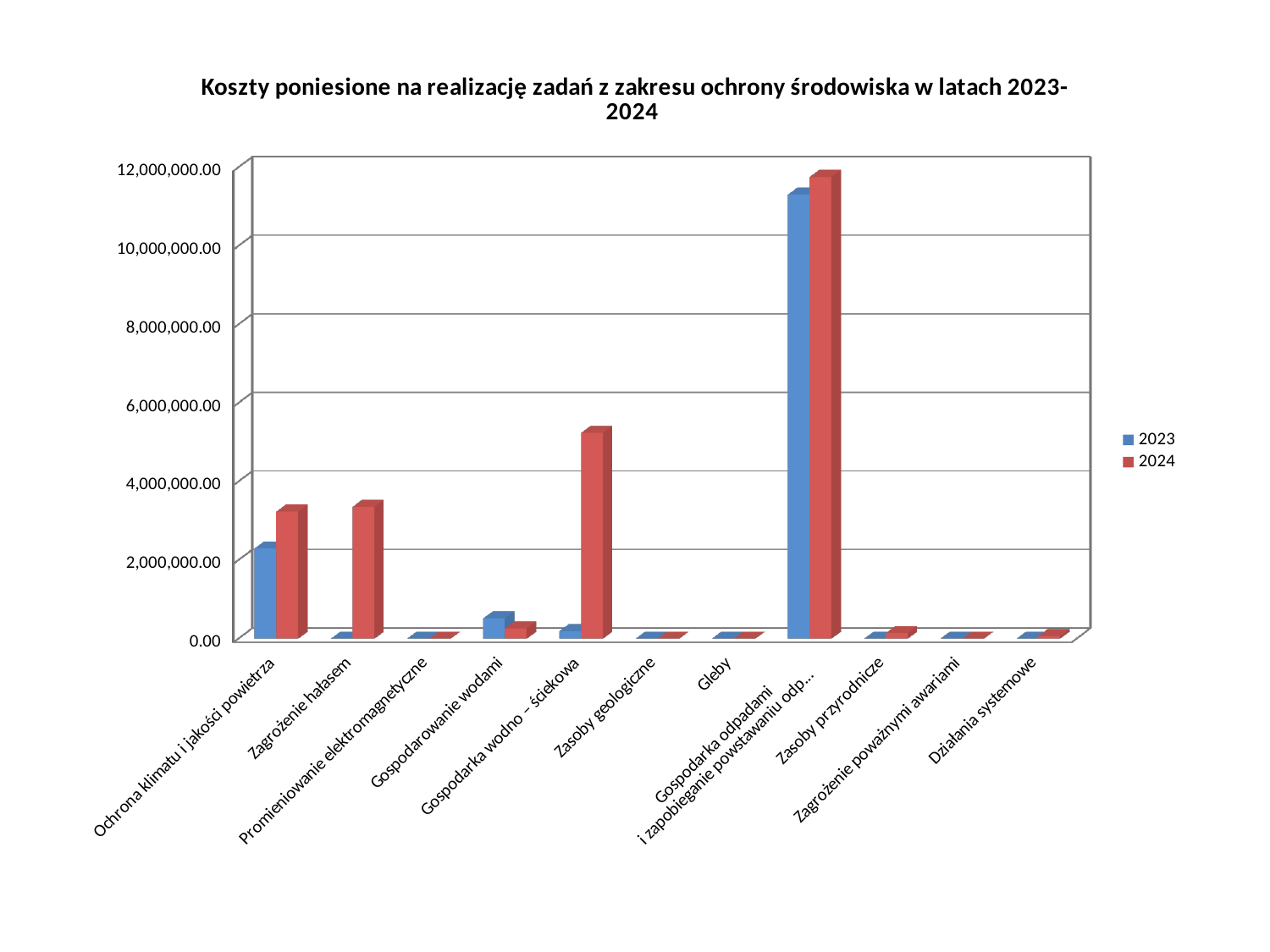
What kind of chart is shown on the slide? Bar chart Is the 2024 value for Gospodarka wodno – ściekowa greater or less than 4,000,000.00? greater Is the 2024 value for Ochrona klimatu i jakości powietrza greater or less than 2,000,000.00? greater For Gospodarka wodno – ściekowa, which year has the larger value, 2023 or 2024? 2024 How many categories are shown on the x axis? 11 Which series is shown in red in the legend? 2024 Which category has the highest value for 2024? Gospodarka odpadami i zapobieganie powstawaniu odp... Which category has the highest value for 2023? Gospodarka odpadami i zapobieganie powstawaniu odp... Is the 2024 value for Zagrożenie hałasem greater or less than 4,000,000.00? less How many series does the legend list? 2 For Gospodarowanie wodami, which year has the larger value, 2023 or 2024? 2023